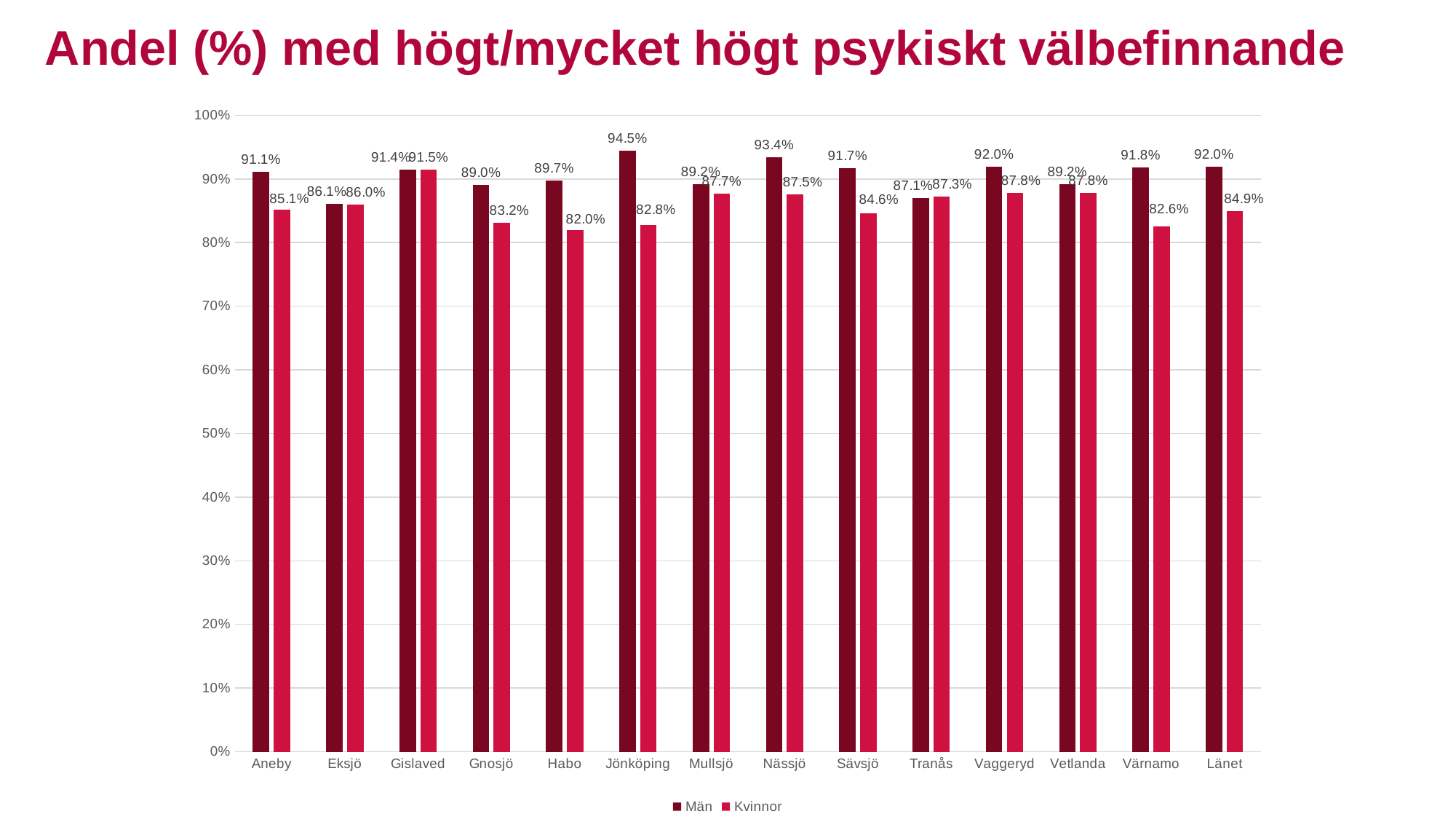
What is the value for Män in Jönköping? 94.5% What kind of chart is shown on the slide? Bar chart Is the value for Kvinnor in Värnamo greater or less than 90%? less How many series does the legend list? 2 Which category has the lowest value for Män? Eksjö What is the value for Kvinnor in Habo? 82.0% Which category has the lowest value for Kvinnor? Habo Which category has the highest value for Män? Jönköping What is the difference between the Män and Kvinnor values in Jönköping? 11.7 percentage points What is the value for Kvinnor in Länet? 84.9% How many categories are shown on the x axis? 14 Which is larger in Habo, the value for Män or for Kvinnor? Män